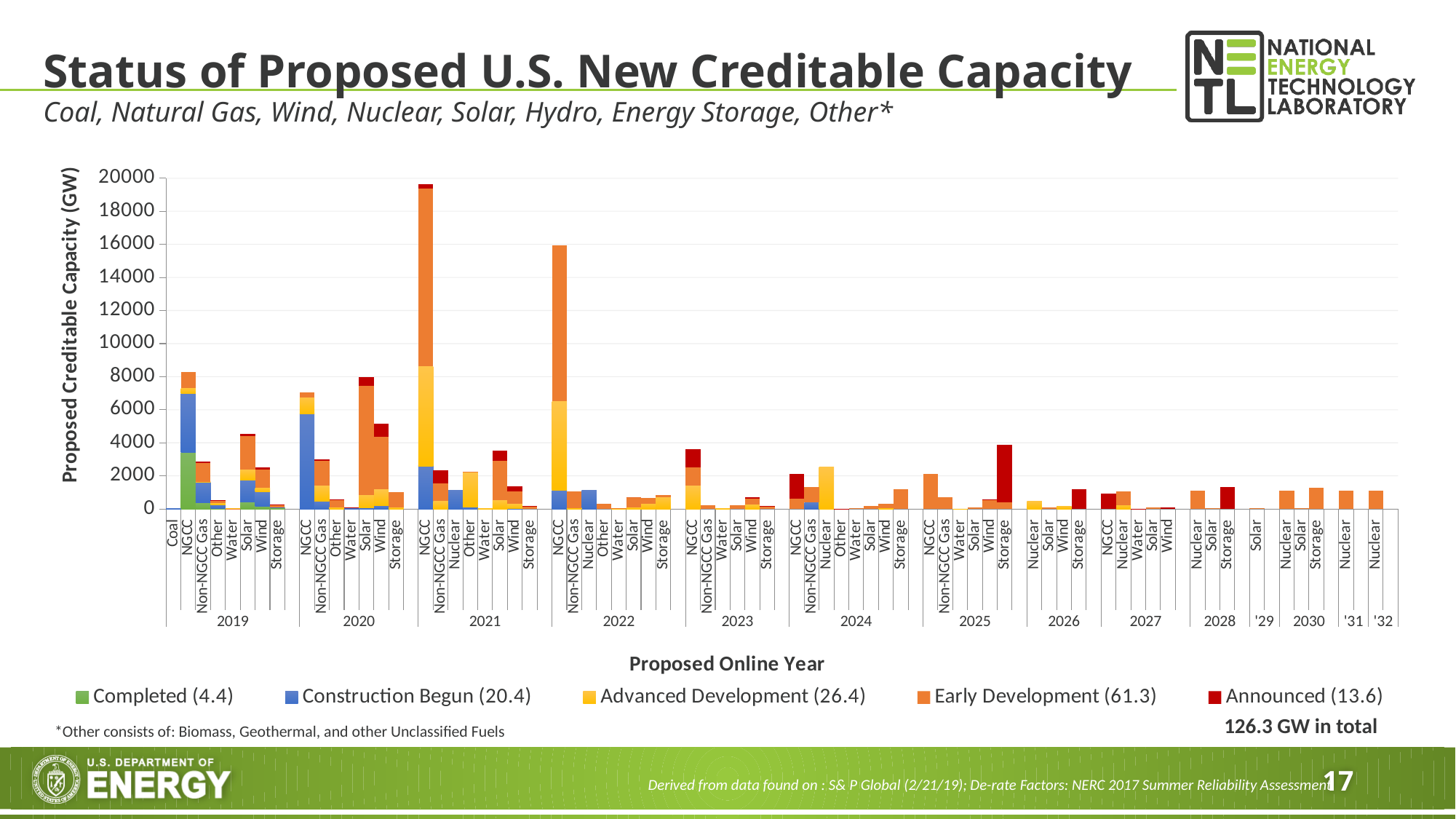
What kind of chart is shown on the slide? Stacked bar chart Is the value for NGCC in 2022 greater or less than 14000? greater Is the value for Storage in 2025 greater or less than 2000? greater Which is larger, the Solar bar for 2020 or the Wind bar for 2020? Solar 2020 Is the value for Nuclear in 2024 greater or less than 4000? less What total capacity does the slide state for all proposed capacity? 126.3 GW in total Which bar is the tallest in the chart? NGCC in 2021 What value is shown in the legend next to Early Development? 61.3 How many series does the legend list? 5 Which is larger, the NGCC bar for 2021 or the NGCC bar for 2022? NGCC 2021 How many fuel categories are shown under the year 2019? 8